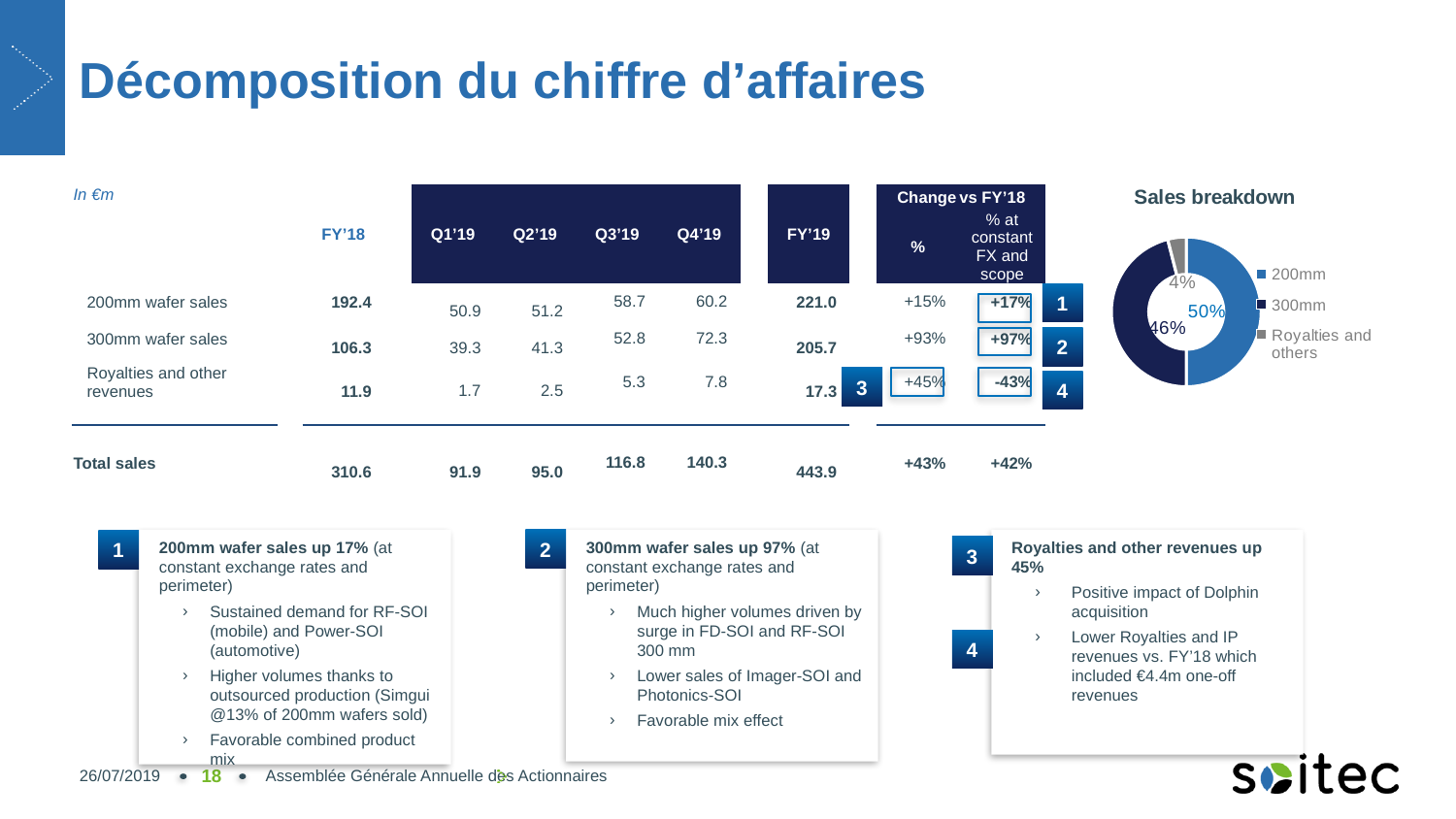
In the "Sales breakdown" chart, what share of sales does 200mm represent? 50% In the "Sales breakdown" chart, which category has the smallest share? Royalties and others How many categories does the "Sales breakdown" chart show? 3 In the "Sales breakdown" chart, what share of sales does 300mm represent? 46% In the "Sales breakdown" chart, what is the difference in percentage points between the 200mm share and the 300mm share? 4 percentage points In the "Sales breakdown" chart, what share of sales do Royalties and others represent? 4% In the "Sales breakdown" chart, which is larger: the 300mm share or the Royalties and others share? 300mm In the "Sales breakdown" chart, which category has the largest share? 200mm How many entries does the legend of the "Sales breakdown" chart list? 3 What is the title of the pie chart on the slide? Sales breakdown What kind of chart is the "Sales breakdown" chart? Pie chart (donut) In the "Sales breakdown" chart, what is the combined share of 200mm and 300mm wafer sales? 96%